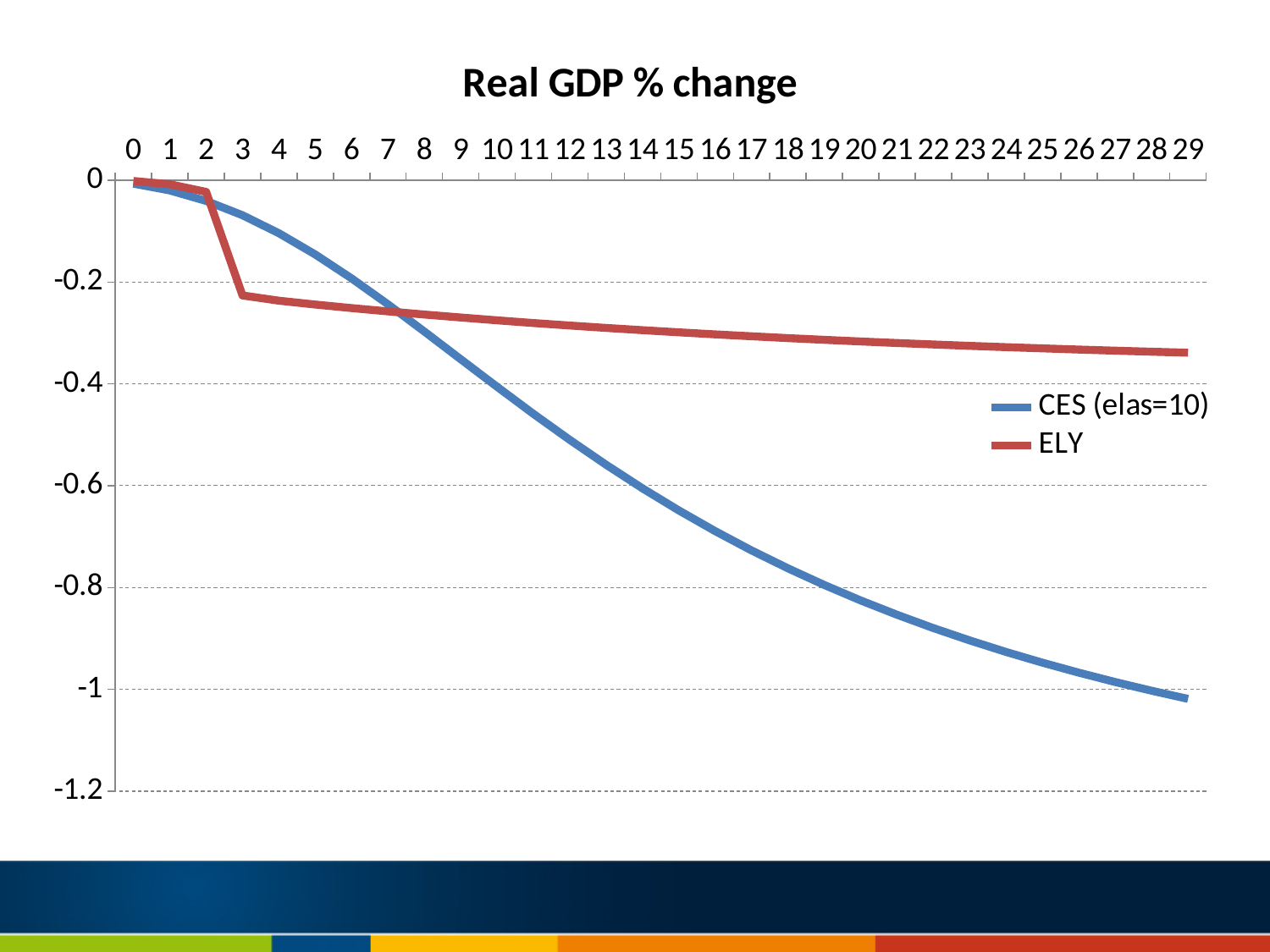
At x = 29, which series has the higher value, CES (elas=10) or ELY? ELY Is the value for ELY at x = 29 greater or less than -0.4? greater How many series does the legend list? 2 How many points are plotted along the x axis for each series? 30 Is the value for ELY at x = 3 greater or less than -0.2? less Is the value for CES (elas=10) at x = 25 greater or less than -0.8? less What kind of chart is shown on the slide? line chart What are the names of the two series in the legend? CES (elas=10) and ELY What is the title of the chart? Real GDP % change Does the CES (elas=10) series rise or fall as the x axis goes from 0 to 29? fall Does the ELY series rise or fall as the x axis goes from 0 to 29? fall